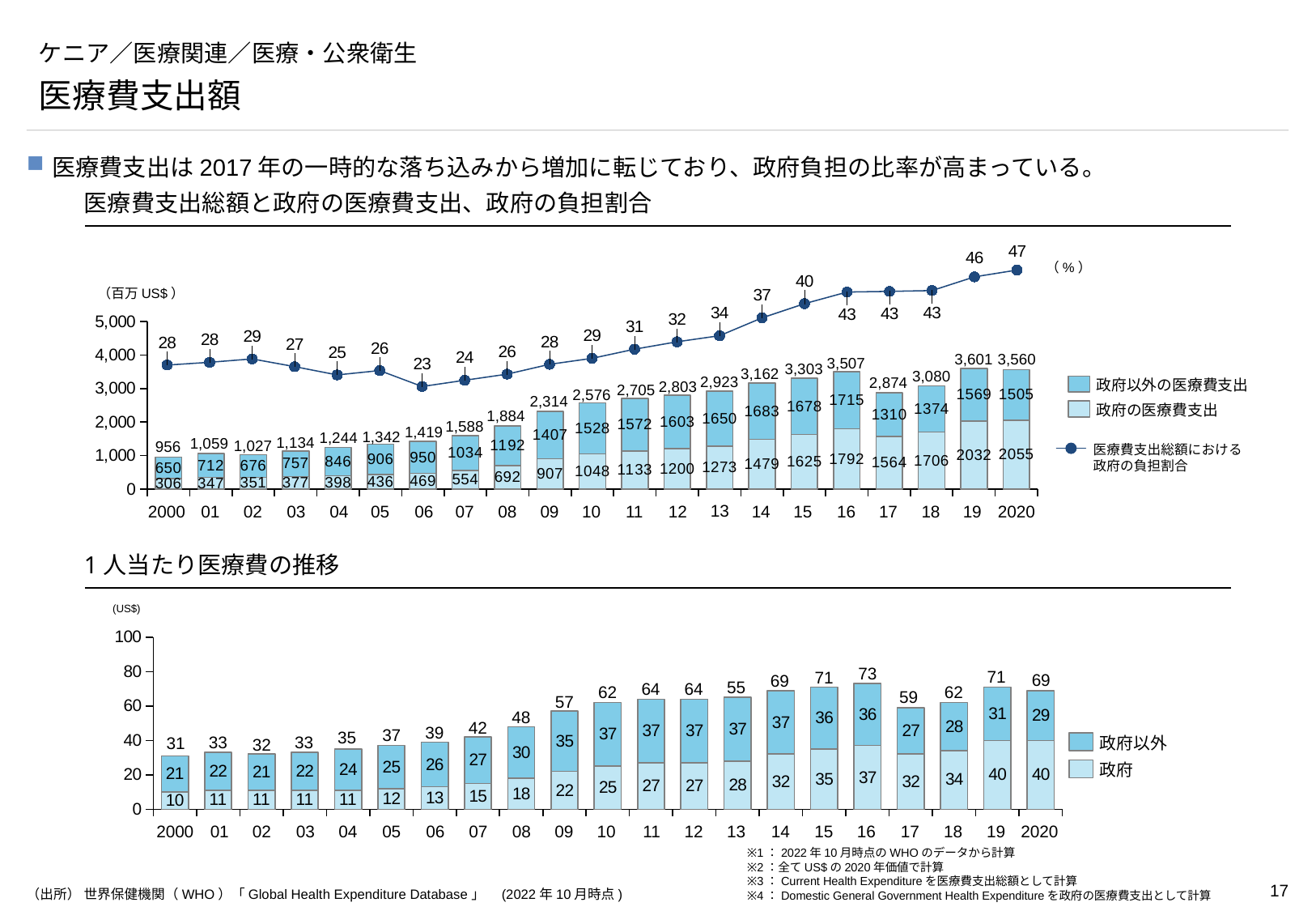
In the top chart (医療費支出総額と政府の医療費支出、政府の負担割合), what is the total health expenditure for 2019? 3,601 In the top chart, what is the government health expenditure (政府の医療費支出) for 2020? 2055 In the top chart, which year has the lowest government share (政府の負担割合) on the line? 2006 What kind of chart is the bottom chart (1人当たり医療費の推移)? Stacked bar chart In the bottom chart, how many years are shown on the x axis? 21 In the bottom chart (1人当たり医療費の推移), what is the per-capita health expenditure total for 2016? 73 In the top chart, what is the government share of total health expenditure (政府の負担割合) in 2006? 23 In the bottom chart, what is the government (政府) per-capita value for 2019? 40 In the top chart, what is the difference between the total health expenditure in 2016 and in 2017? 633 In the top chart, which year has the highest total health expenditure? 2019 In the bottom chart, which is larger in 2017: the 政府 value or the 政府以外 value? 政府 In the top chart, how many series does the legend list? 3